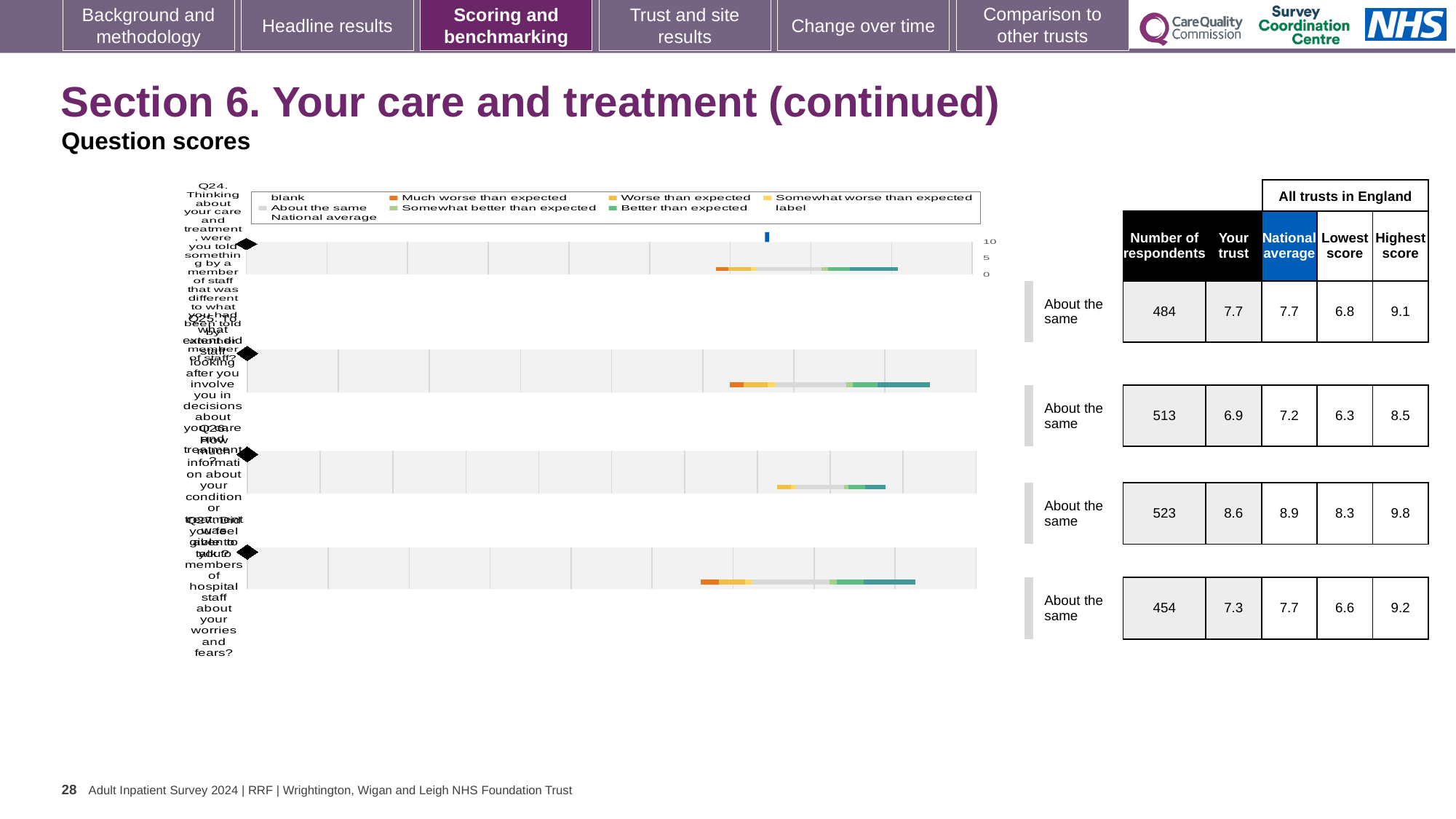
Which legend entry is shown in orange in the chart legend? Much worse than expected How many question charts (Q24 to Q27) are shown on the slide? 4 Which of the four questions (Q24 to Q27) has the highest 'Your trust' score? Q26 Which of the four questions (Q24 to Q27) has the lowest 'Your trust' score? Q25 What is the difference between the highest score and the lowest score for Q24? 2.3 How many entries does the chart legend list? 9 What is the 'Your trust' score for Q24 (told something different by another member of staff)? 7.7 Is the 'Your trust' score for Q26 larger than the 'Your trust' score for Q25? Yes What kind of chart is used for the question scores on this slide? bar chart What is the highest score across all trusts in England for Q27 (able to talk to staff about worries and fears)? 9.2 What is the national average score for Q25 (staff involving you in decisions about your care and treatment)? 7.2 How many respondents answered Q26 (how much information about your condition or treatment was given to you)? 523